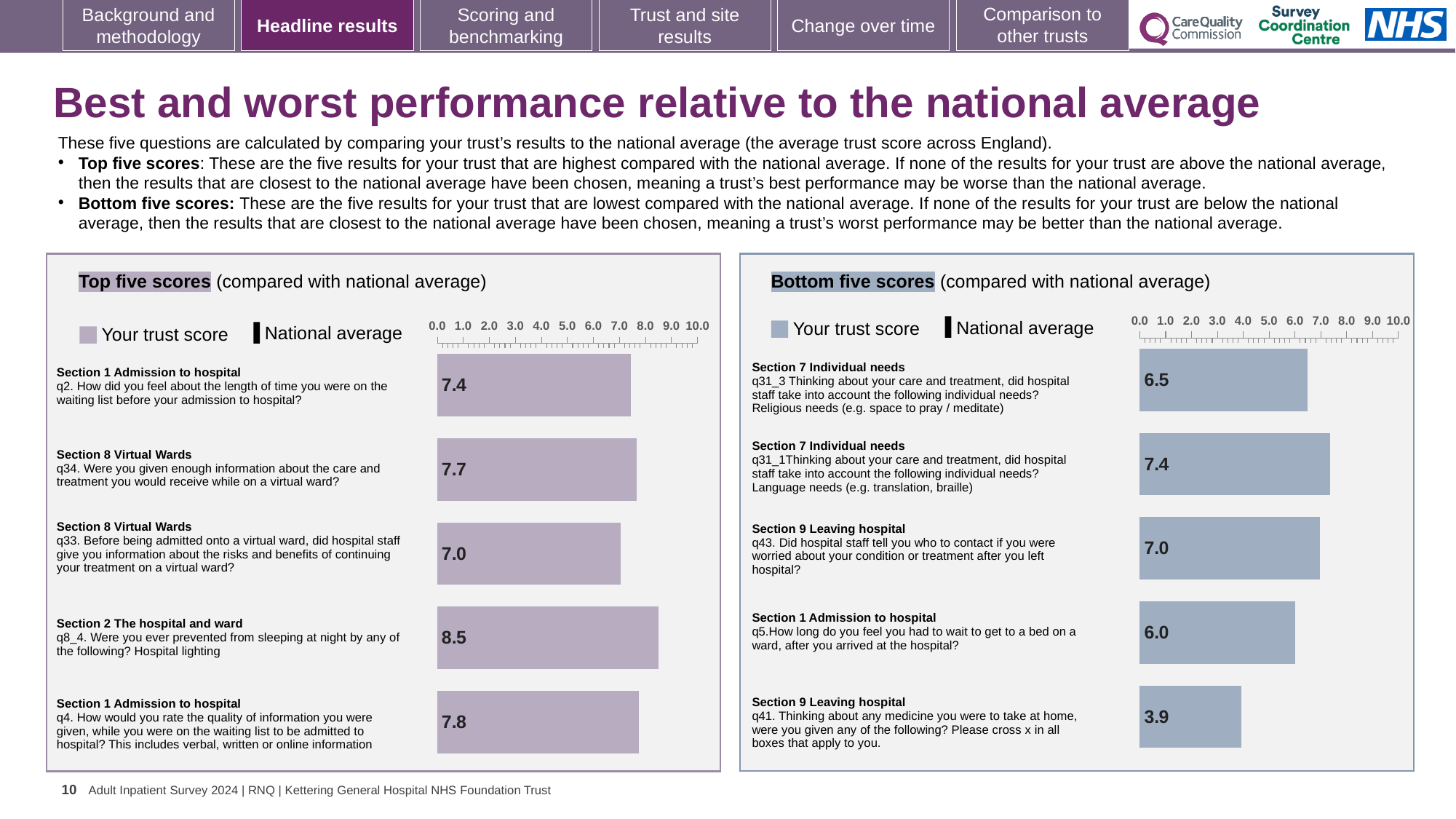
What type of chart is used for the Bottom five scores? Bar chart In the Top five scores chart, what is the trust score for q34 (information about care and treatment on a virtual ward)? 7.7 How many questions are shown in the Top five scores chart? 5 In the Top five scores chart, what is the difference between the trust scores for q8_4 and q2? 1.1 In the Top five scores chart, which question has the lowest trust score? q33 In the Bottom five scores chart, which question has the highest trust score? q31_1 (Language needs) In the Bottom five scores chart, what is the difference between the trust scores for q31_1 and q41? 3.5 In the Bottom five scores chart, which has the larger trust score: q31_3 (Religious needs) or q5 (wait to get to a bed)? q31_3 In the Top five scores chart, which question has the highest trust score? q8_4 (Hospital lighting) How many series does the legend of the Top five scores chart list? 2 In the Bottom five scores chart, which question has the lowest trust score? q41 In the Bottom five scores chart, what is the trust score for q41 (medicine to take at home)? 3.9